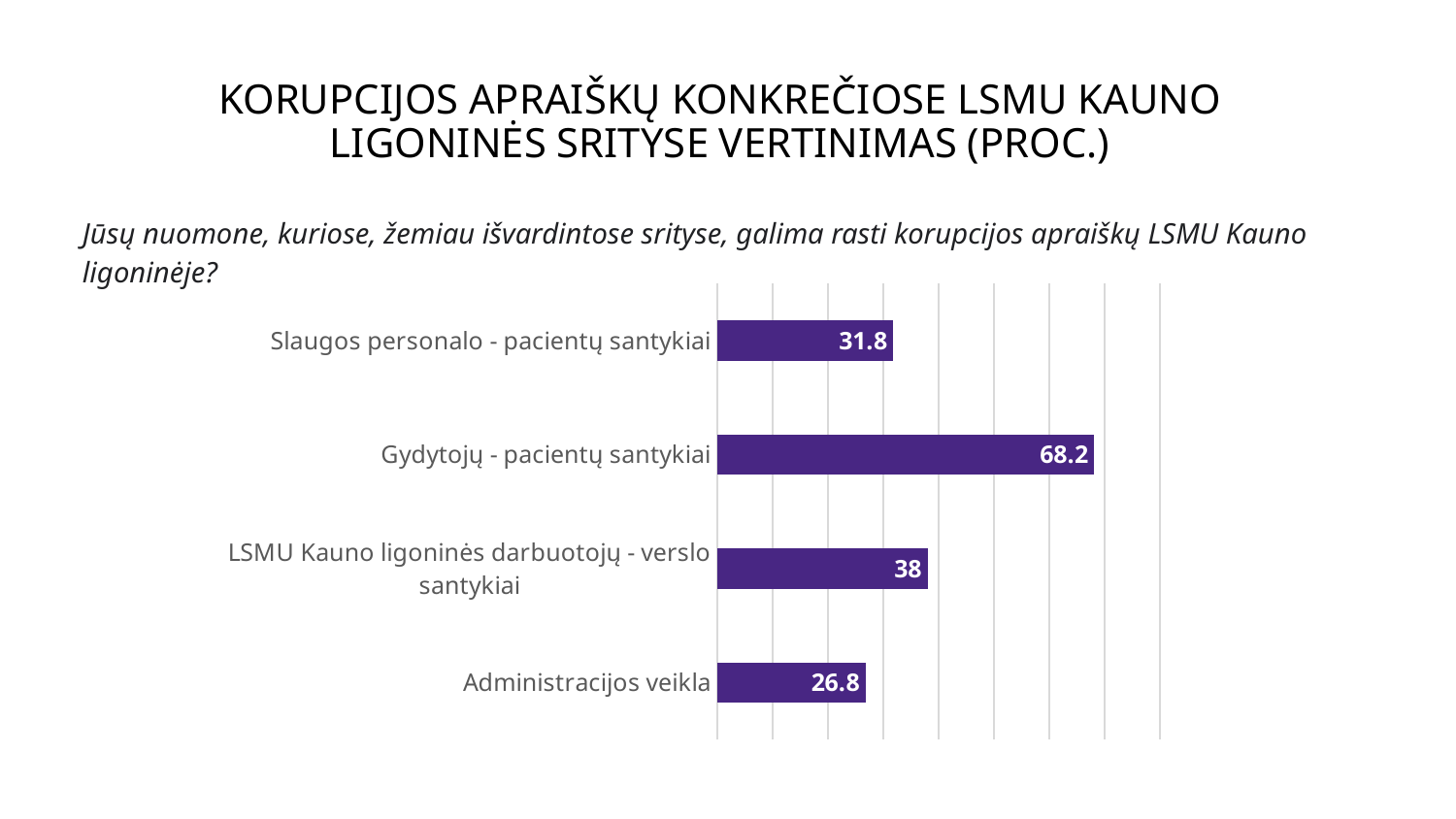
What is the value for Administracijos veikla? 26.8 What is the difference between the values for Gydytojų - pacientų santykiai and Slaugos personalo - pacientų santykiai? 36.4 Which is larger: the value for Slaugos personalo - pacientų santykiai or the value for LSMU Kauno ligoninės darbuotojų - verslo santykiai? LSMU Kauno ligoninės darbuotojų - verslo santykiai Which category has the highest value? Gydytojų - pacientų santykiai What is the value for Slaugos personalo - pacientų santykiai? 31.8 Which category has the lowest value? Administracijos veikla What colour are the bars in the chart? Purple What is the value for LSMU Kauno ligoninės darbuotojų - verslo santykiai? 38 What is the difference between the values for LSMU Kauno ligoninės darbuotojų - verslo santykiai and Administracijos veikla? 11.2 What is the value for Gydytojų - pacientų santykiai? 68.2 What kind of chart is shown on the slide? Bar chart How many categories are shown in the chart? 4